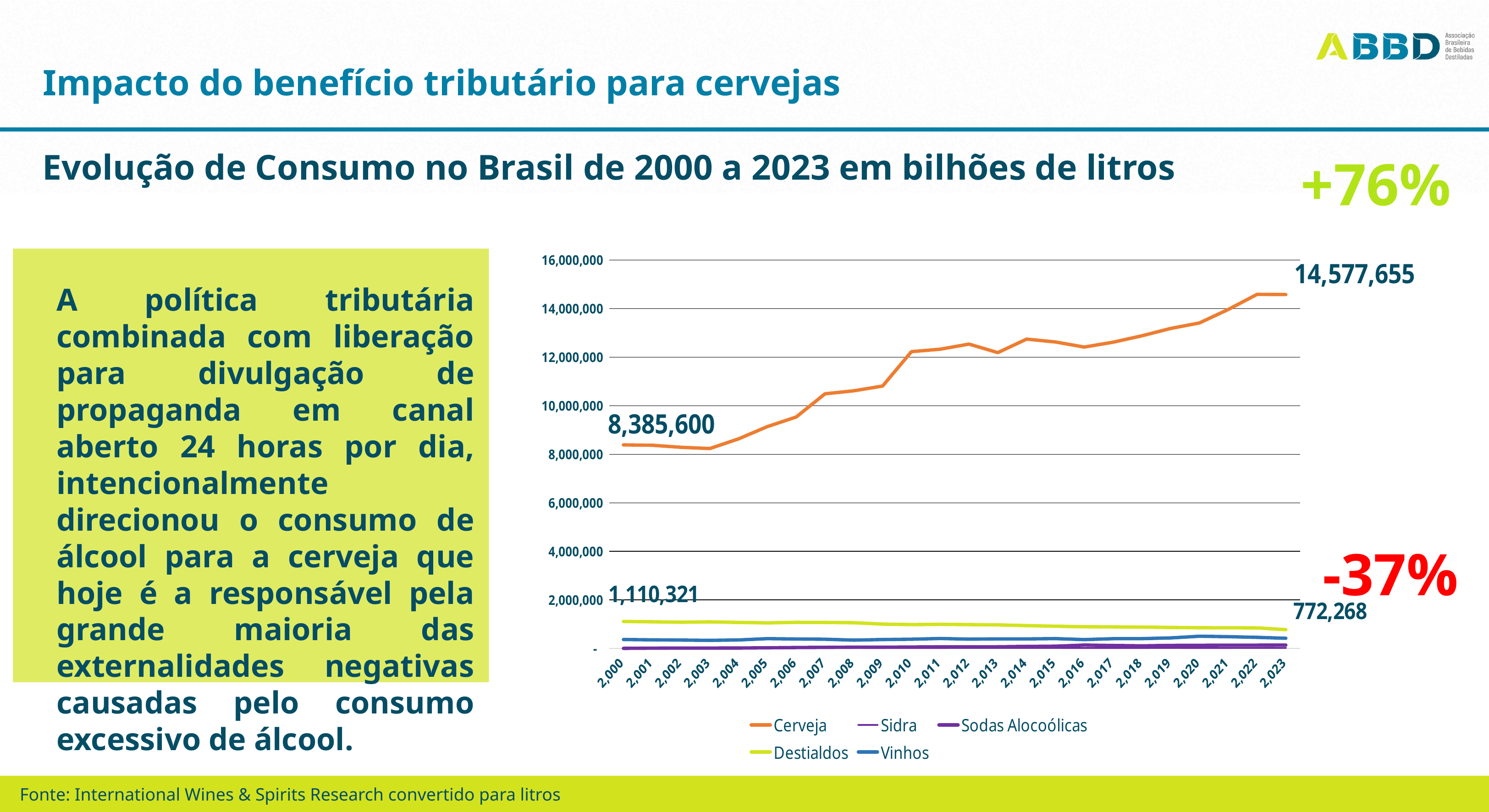
What is the value for Destilados in 2000? 1,110,321 Does the Cerveja line rise or fall from 2000 to 2023? Rises By how much did the Destilados value decrease from 2000 to 2023? 338,053 What is the value for Destilados in 2023? 772,268 How many series does the legend list? 5 By how much did the Cerveja value increase from 2000 to 2023? 6,192,055 What is the value for Cerveja in 2023? 14,577,655 What is the value for Cerveja in 2000? 8,385,600 Is the value for Cerveja in 2005 greater or less than 10,000,000? less How many years are shown on the x axis? 24 Which series has the highest values throughout the chart? Cerveja What kind of chart is shown on the slide? Line chart